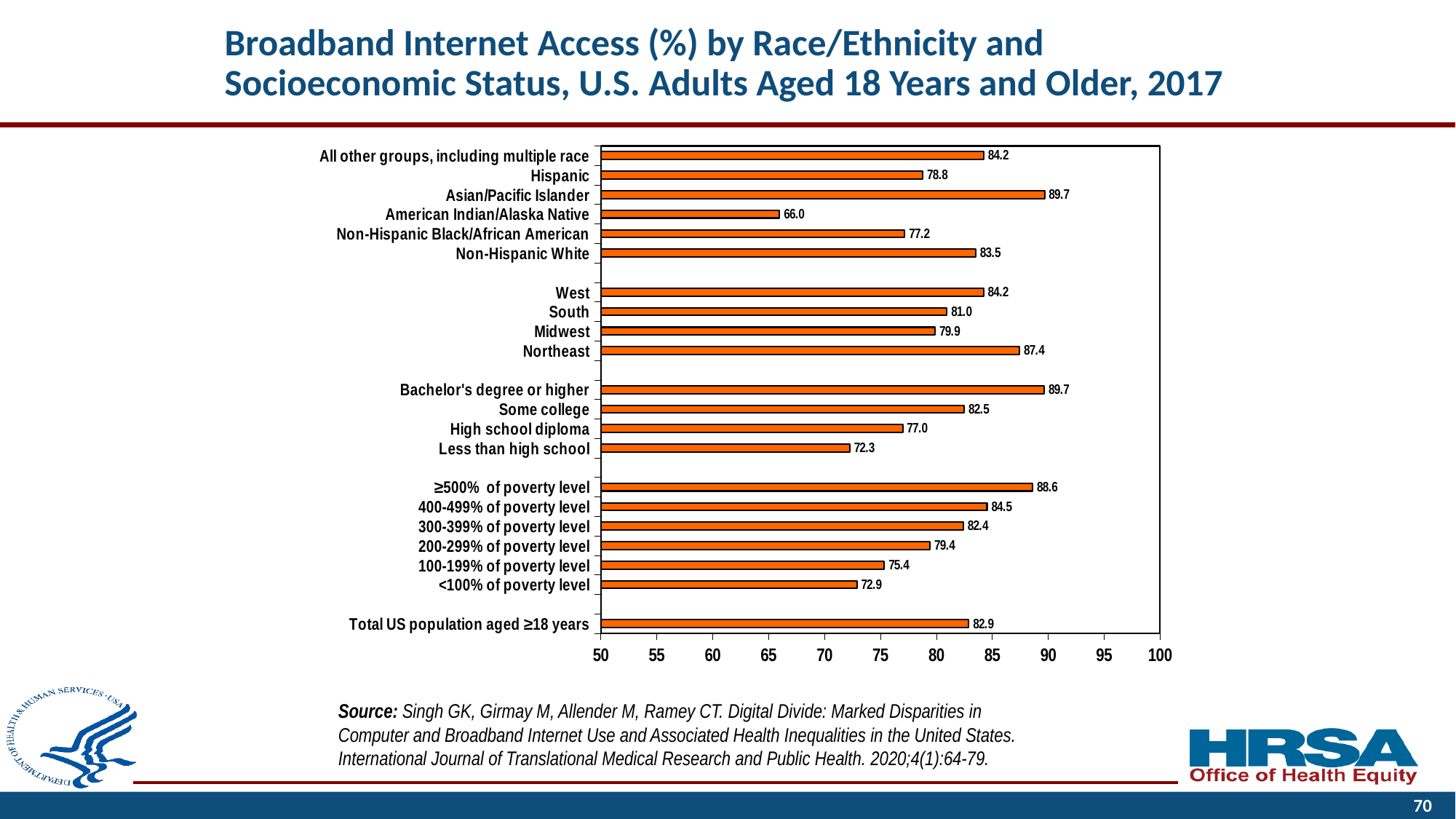
What is the value for adults with less than high school education? 72.3 Among the four regions (West, South, Midwest, Northeast), which has the highest value? Northeast What is the value for the ≥500% of poverty level group? 88.6 What is the broadband internet access value for Hispanic adults? 78.8 What type of chart is shown on the slide? Bar chart What is the difference between the Northeast and Midwest values? 7.5 Is the value for 100-199% of poverty level greater or less than 80? less Which category has the lowest broadband internet access value? American Indian/Alaska Native How many bars are plotted in the chart? 21 What is the value shown for the Total US population aged ≥18 years? 82.9 Which is larger, the value for Non-Hispanic White or Non-Hispanic Black/African American? Non-Hispanic White What is the difference between the values for Bachelor's degree or higher and Less than high school? 17.4